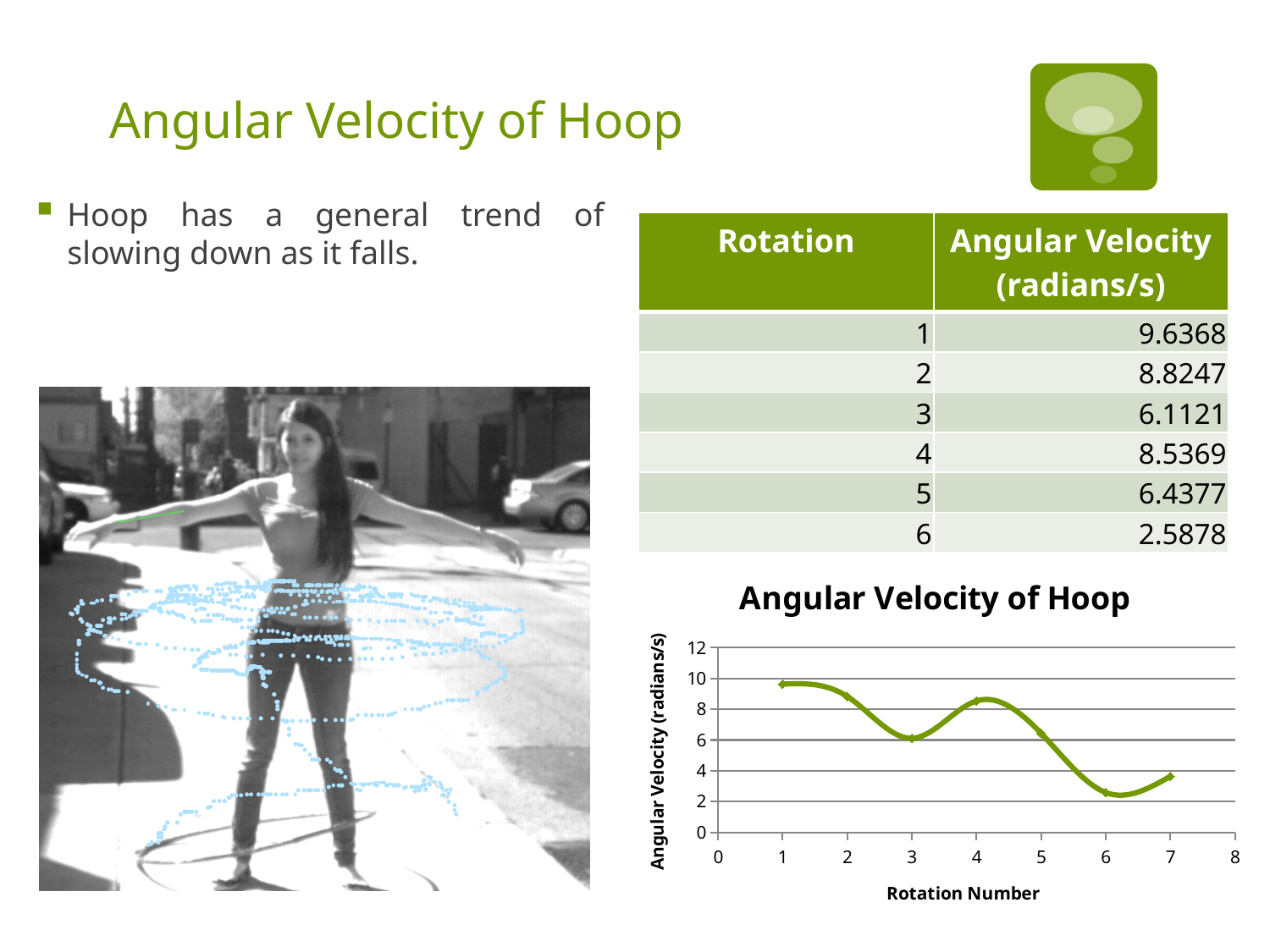
Overall, do the angular velocity values rise or fall as the rotation number increases? fall What kind of chart is shown on the slide? line chart Is the angular velocity plotted at rotation number 7 greater or less than 4? less According to the table, what is the angular velocity for rotation 6? 2.5878 According to the table, what is the angular velocity for rotation 1? 9.6368 What is the title of the chart? Angular Velocity of Hoop Which rotation number has the lowest angular velocity in the chart? 6 According to the table, what is the angular velocity for rotation 4? 8.5369 What is the difference in angular velocity between rotation 1 and rotation 2 in the table? 0.8121 Which rotation number has the highest angular velocity in the chart? 1 Which has the larger angular velocity, rotation 3 or rotation 5? rotation 5 What is the label of the y axis of the chart? Angular Velocity (radians/s)